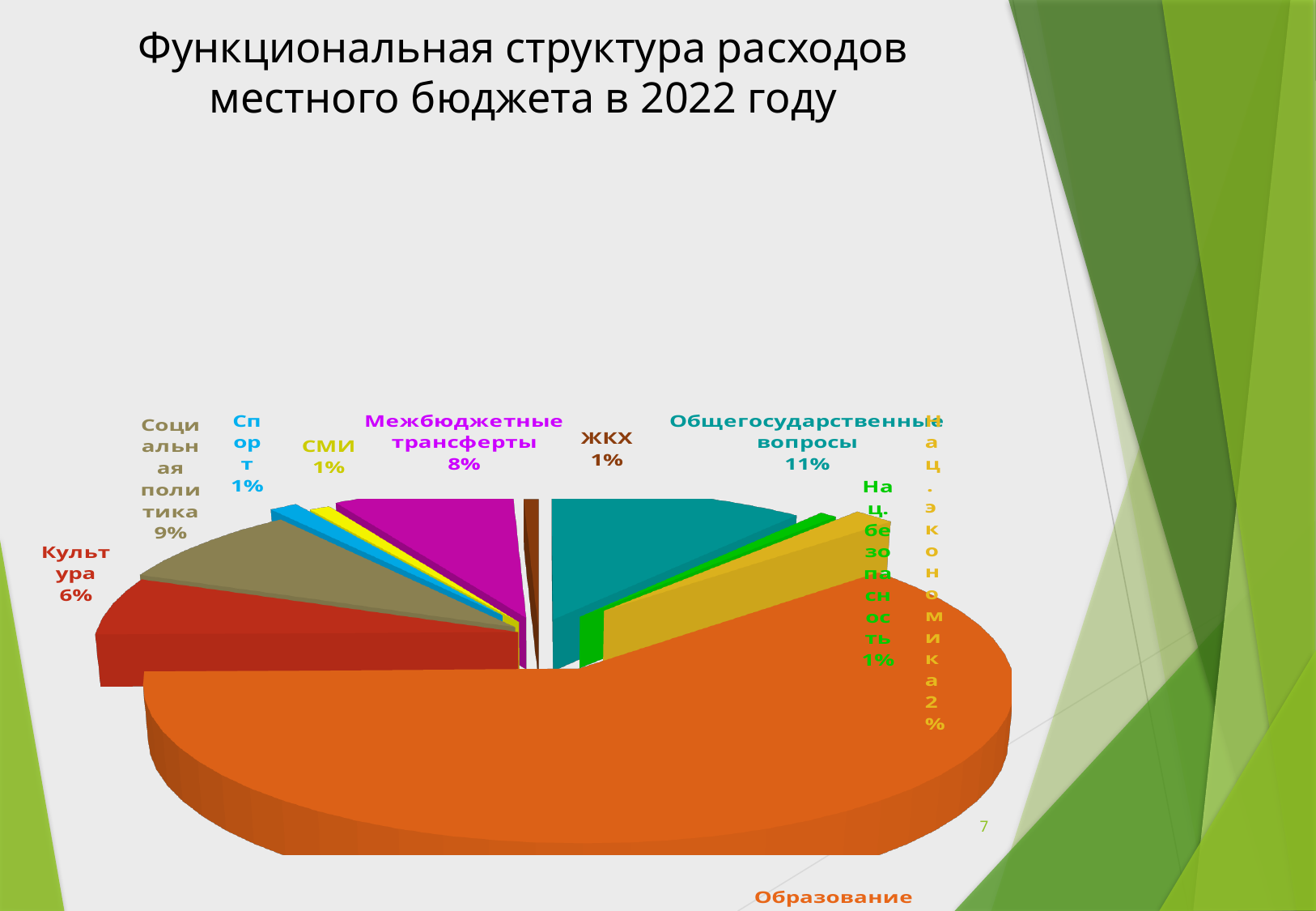
How many categories are shown in the pie chart? 10 Which category has the largest slice of the pie? Образование What share of expenditure is labelled for Общегосударственные вопросы? 11% What is the chart's title? Функциональная структура расходов местного бюджета в 2022 году What share is labelled for Межбюджетные трансферты? 8% What is the difference between the shares of Общегосударственные вопросы and Культура? 5% What kind of chart is shown on the slide? pie chart What share is labelled for Культура? 6% What share is labelled for Социальная политика? 9% Which is larger, Социальная политика or Межбюджетные трансферты? Социальная политика What share is labelled for Нац. экономика? 2% What share is labelled for ЖКХ? 1%